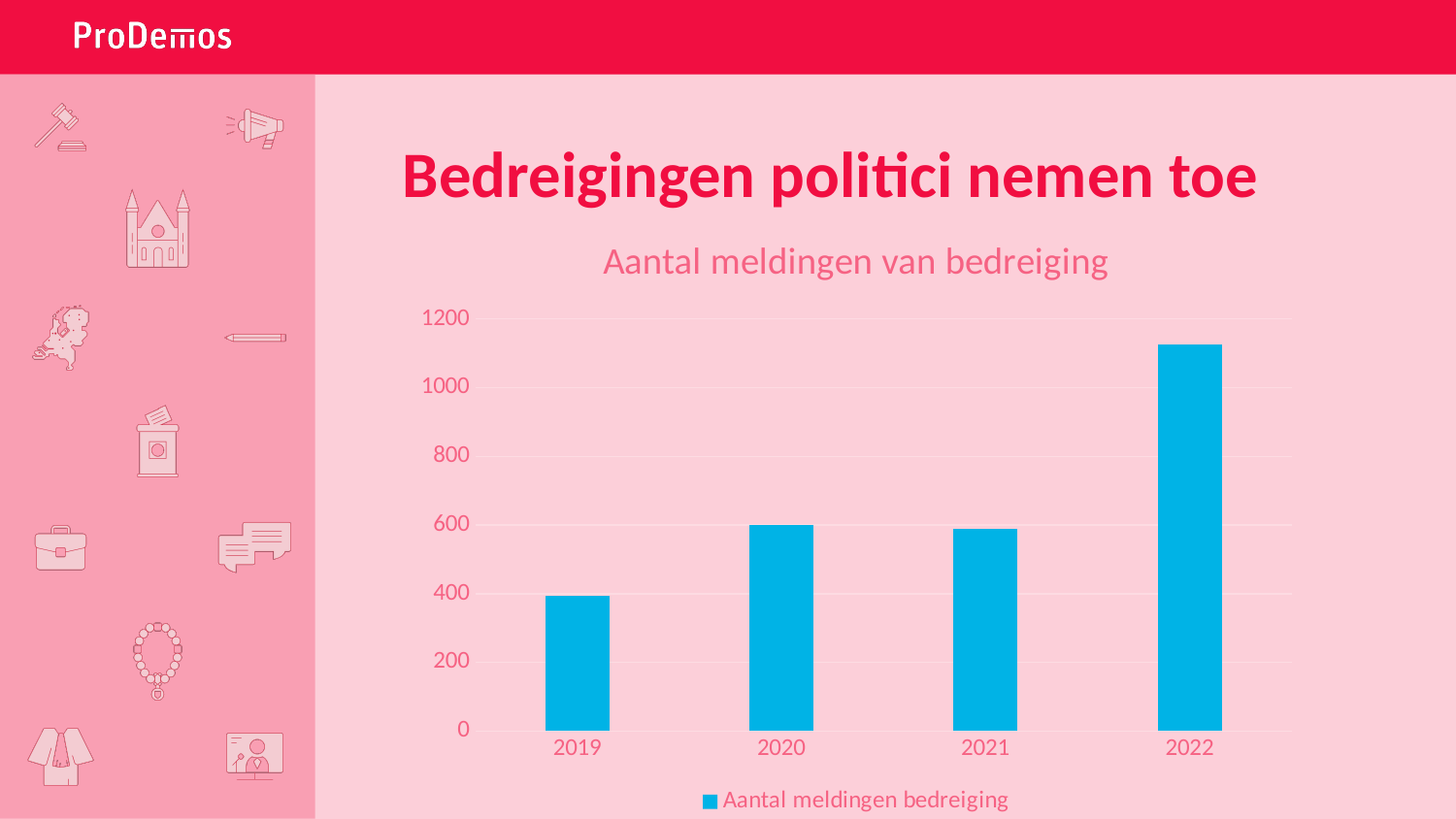
Is the value for 2021 greater or less than 800? less What is the title of the chart? Aantal meldingen van bedreiging Which is larger, the value for 2022 or the value for 2020? 2022 How many years are shown on the x axis of the chart? 4 What is the legend entry for the series in the chart? Aantal meldingen bedreiging Is the value for 2019 greater or less than 200? greater Which year has the highest number of reports? 2022 Which year has the lowest number of reports? 2019 How many series does the legend list? 1 Is the value for 2022 greater or less than 1000? greater What kind of chart is shown on the slide? bar chart